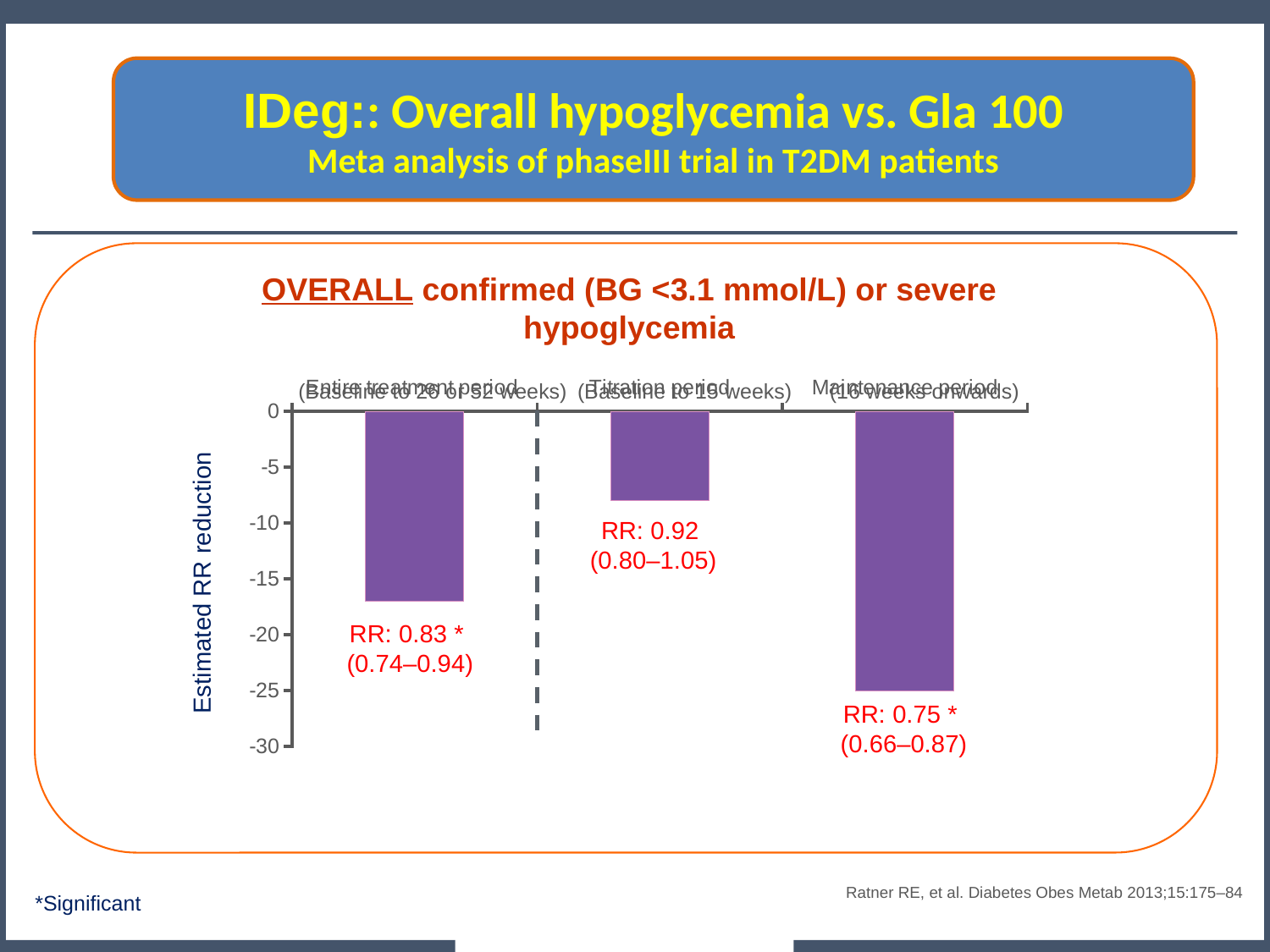
Which period has the highest (least negative) estimated RR reduction bar? Titration period What confidence interval is printed for the Maintenance period? 0.66–0.87 How many bars (periods) are plotted in the chart? 3 Is the value for the Entire treatment period greater or less than -15? less What is the RR printed for the Maintenance period? 0.75 What is the label on the vertical axis of the chart? Estimated RR reduction What kind of chart is shown on the slide? bar chart What confidence interval is printed for the Entire treatment period? 0.74–0.94 Which has the lower RR, the Entire treatment period or the Maintenance period? Maintenance period Is the value for the Titration period greater or less than -10? greater Which period has the lowest (most negative) estimated RR reduction bar? Maintenance period What is the RR printed for the Titration period? 0.92